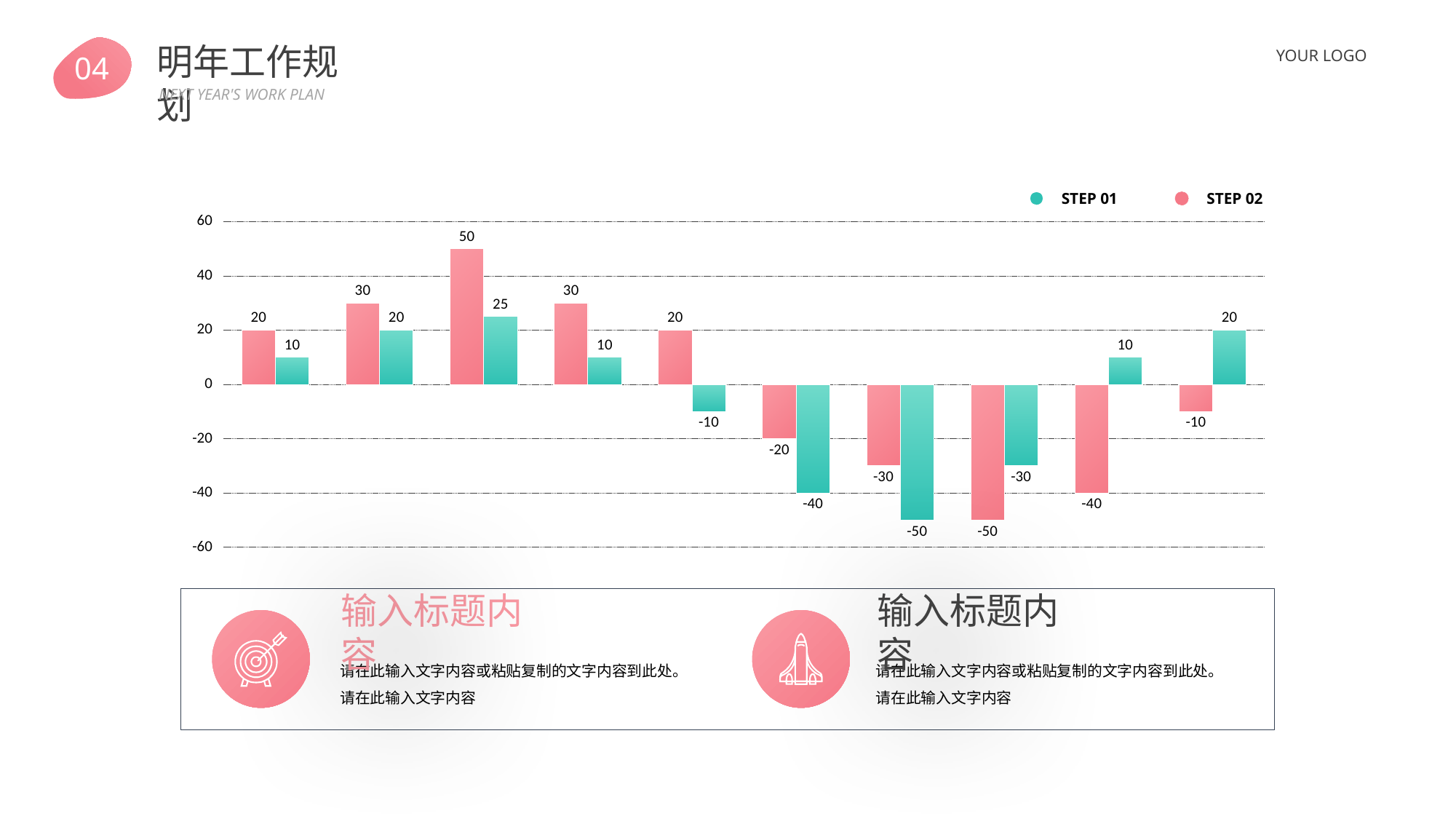
What are the two entries listed in the chart legend? STEP 01 and STEP 02 How many groups of bars are plotted along the x axis? 10 What is the highest value shown on the vertical axis? 60 What is the lowest value labelled on any bar in the chart? -50 What is the value of the pink bar in the third group from the left? 50 What type of chart is shown on the slide? bar chart In the sixth group from the left, which bar is larger, the pink bar or the teal bar? the pink bar What is the highest value labelled on any bar in the chart? 50 What is the difference between the pink bar and the teal bar in the third group from the left? 25 How many series does the chart legend list? 2 What is the value of the teal bar in the rightmost group? 20 What is the value of the teal bar in the seventh group from the left? -50